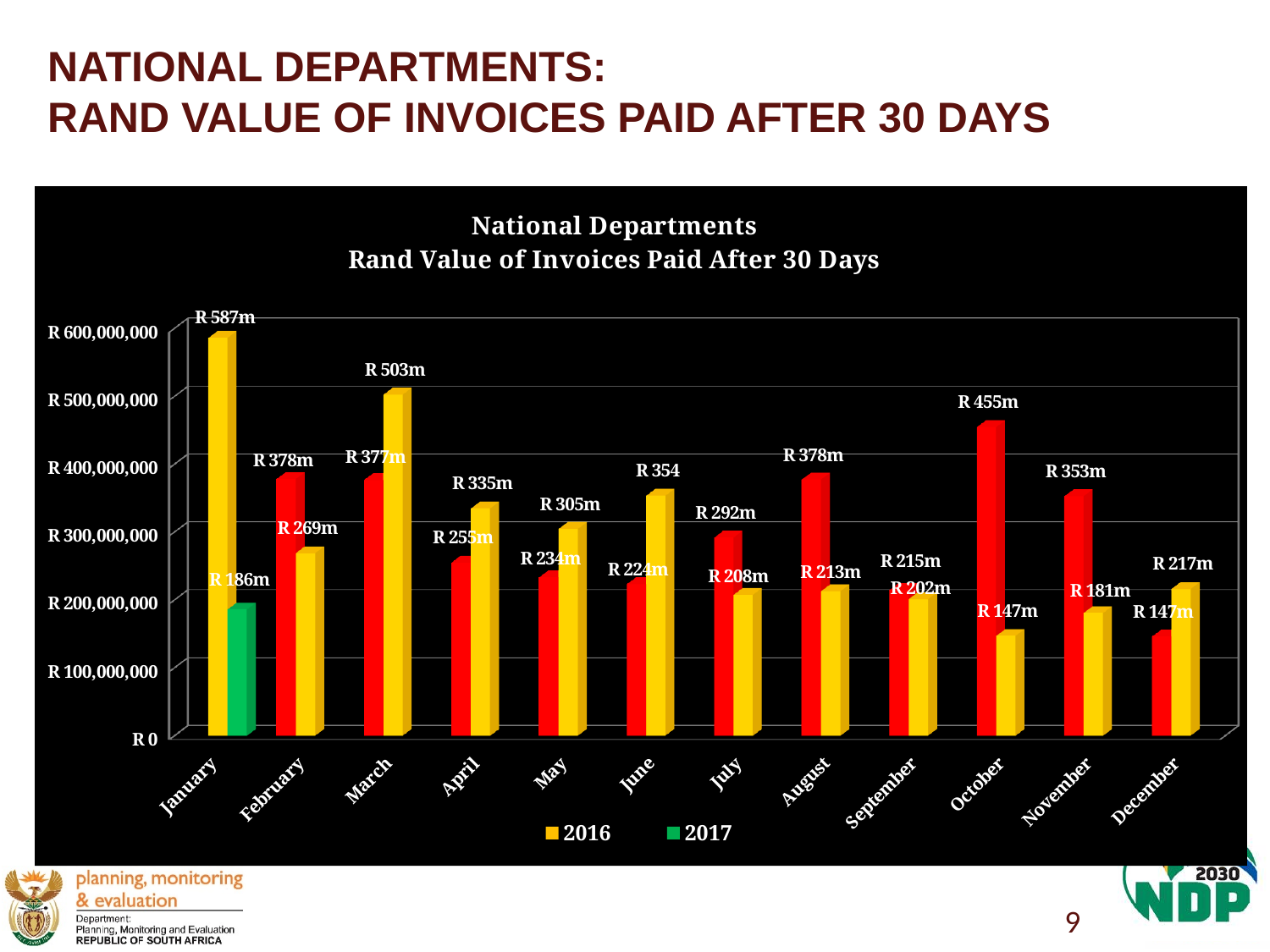
What is the 2016 value for January? R 587m How many months are shown on the x axis? 12 Which month has the lowest 2016 value? October What is the difference between the 2016 and 2017 values for January? R 401m Which month has the highest 2016 value? January Which is larger, the 2016 value for March or the 2016 value for April? March What is the 2016 value for March? R 503m What kind of chart is shown on the slide? bar chart How many series does the legend list? 2 What is the 2016 value for October? R 147m Is the 2016 value for January greater or less than R 500,000,000? greater What is the 2017 value for January? R 186m